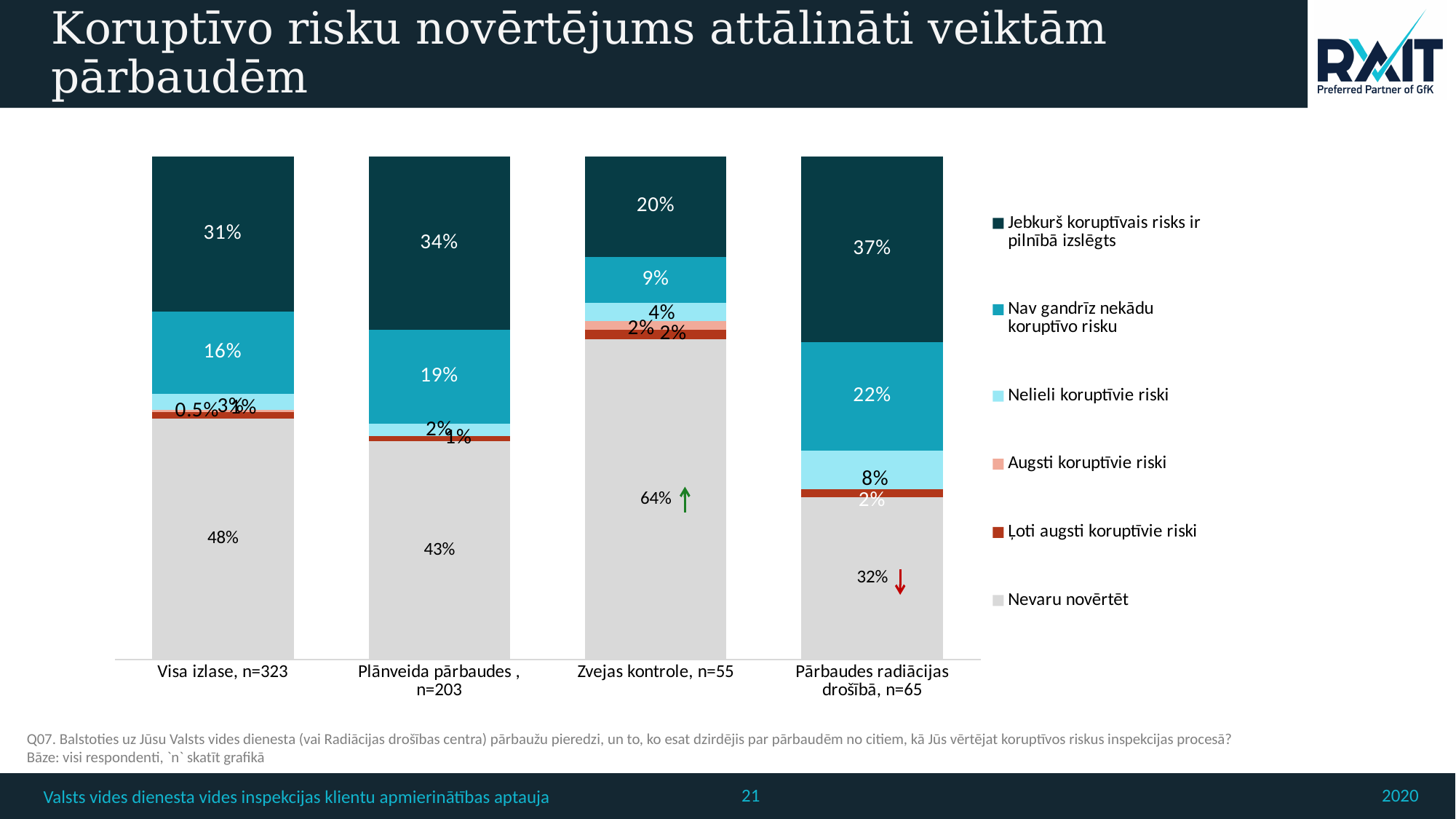
What is the value of "Jebkurš koruptīvais risks ir pilnībā izslēgts" for Pārbaudes radiācijas drošībā, n=65? 37% Which is larger: "Nav gandrīz nekādu koruptīvo risku" for Pārbaudes radiācijas drošībā, n=65 or for Visa izlase, n=323? Pārbaudes radiācijas drošībā, n=65 What is the value of "Nevaru novērtēt" for Visa izlase, n=323? 48% How many series does the legend list? 6 What is the value of "Nelieli koruptīvie riski" for Pārbaudes radiācijas drošībā, n=65? 8% What is the difference between the "Nevaru novērtēt" values for Zvejas kontrole, n=55 and Pārbaudes radiācijas drošībā, n=65? 32 percentage points What is the value of "Nevaru novērtēt" for Zvejas kontrole, n=55? 64% What kind of chart is shown on the slide? Stacked bar chart What is the value of "Nav gandrīz nekādu koruptīvo risku" for Plānveida pārbaudes, n=203? 19% Which category has the lowest value for "Jebkurš koruptīvais risks ir pilnībā izslēgts"? Zvejas kontrole, n=55 Which category has the highest value for "Nevaru novērtēt"? Zvejas kontrole, n=55 How many categories are shown on the x axis? 4